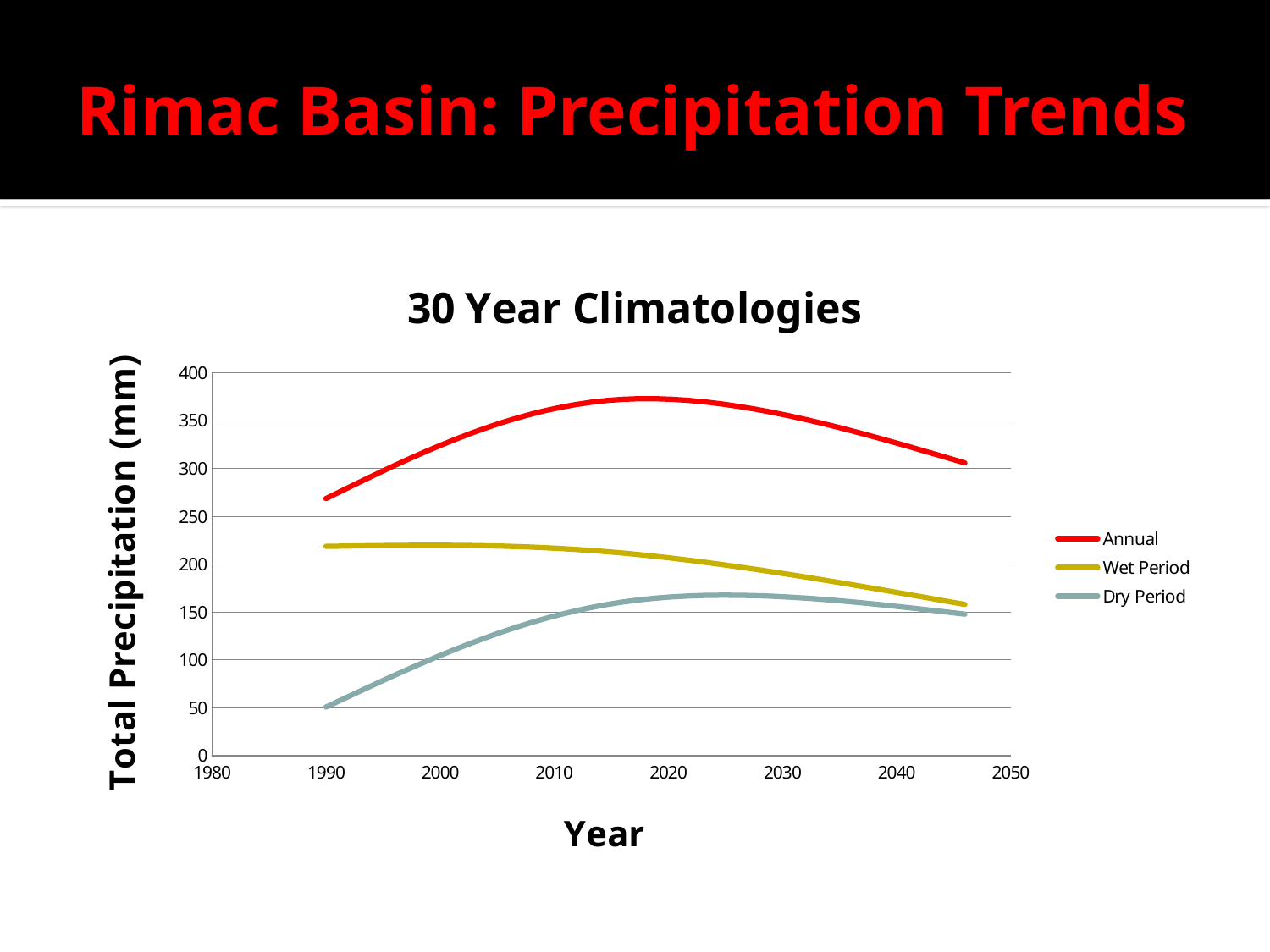
Is the value for Wet Period in 2040 greater or less than 200? less Which series has the highest values across the whole chart? Annual Is the value for Dry Period in 2020 greater or less than 150? greater Is the value for Annual in 2020 greater or less than 350? greater How many series does the legend list? 3 What is the title of the chart? 30 Year Climatologies Does the Dry Period line rise or fall between 1990 and 2020? rise What is the label of the vertical axis? Total Precipitation (mm) Which is larger in 2000, Wet Period or Dry Period? Wet Period What kind of chart is shown on the slide? line chart